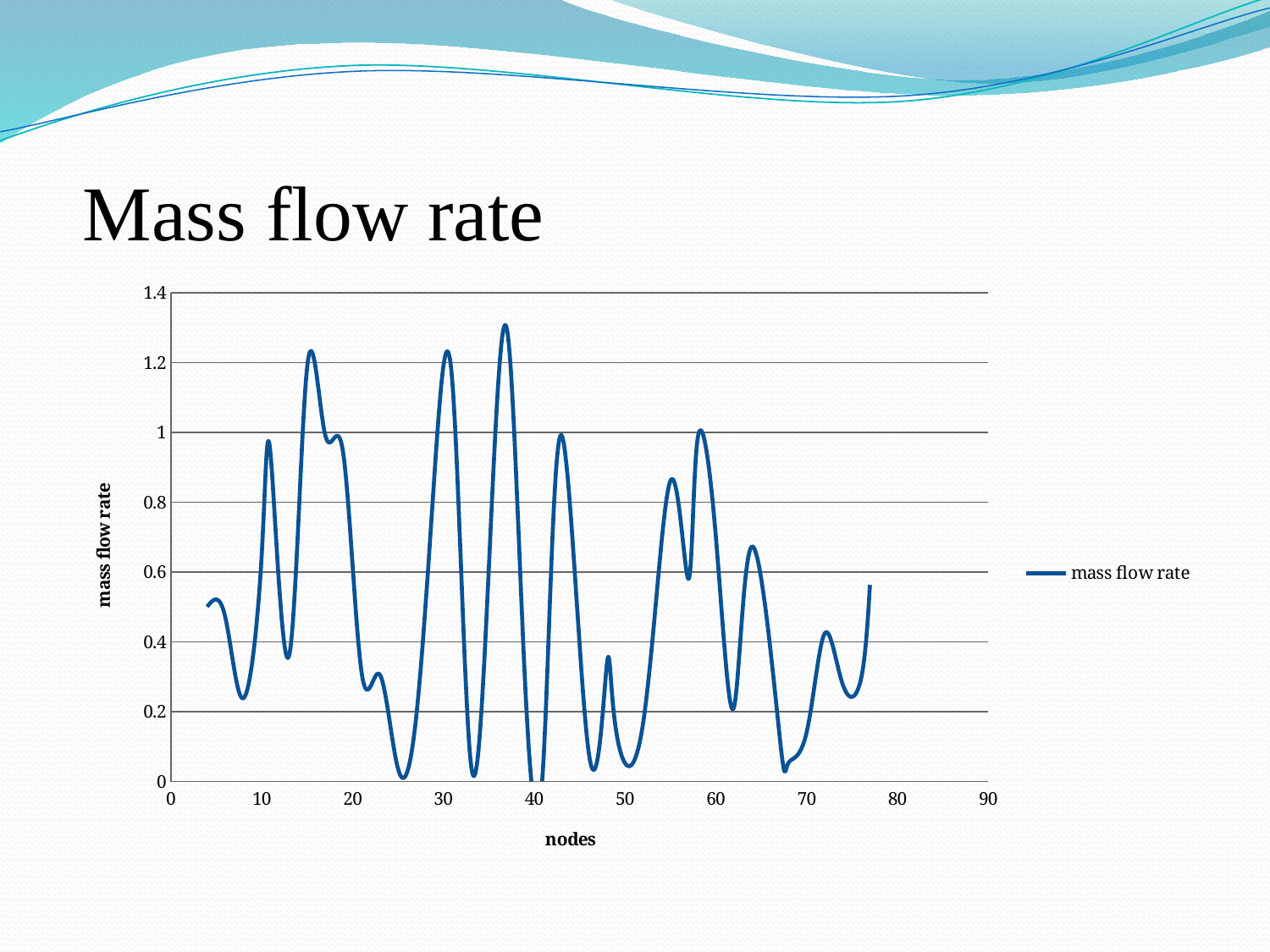
Is the value of the line near node 4 greater or less than 0.4? greater Is the value of the line near node 68 greater or less than 0.2? less Is the peak value of the line near node 30 greater or less than 1? greater How many series does the legend list? 1 What is the label of the x axis? nodes Does the line reach its highest value before or after node 40? before What kind of chart is shown on the slide? line chart Does the line rise or fall between node 20 and node 26? fall